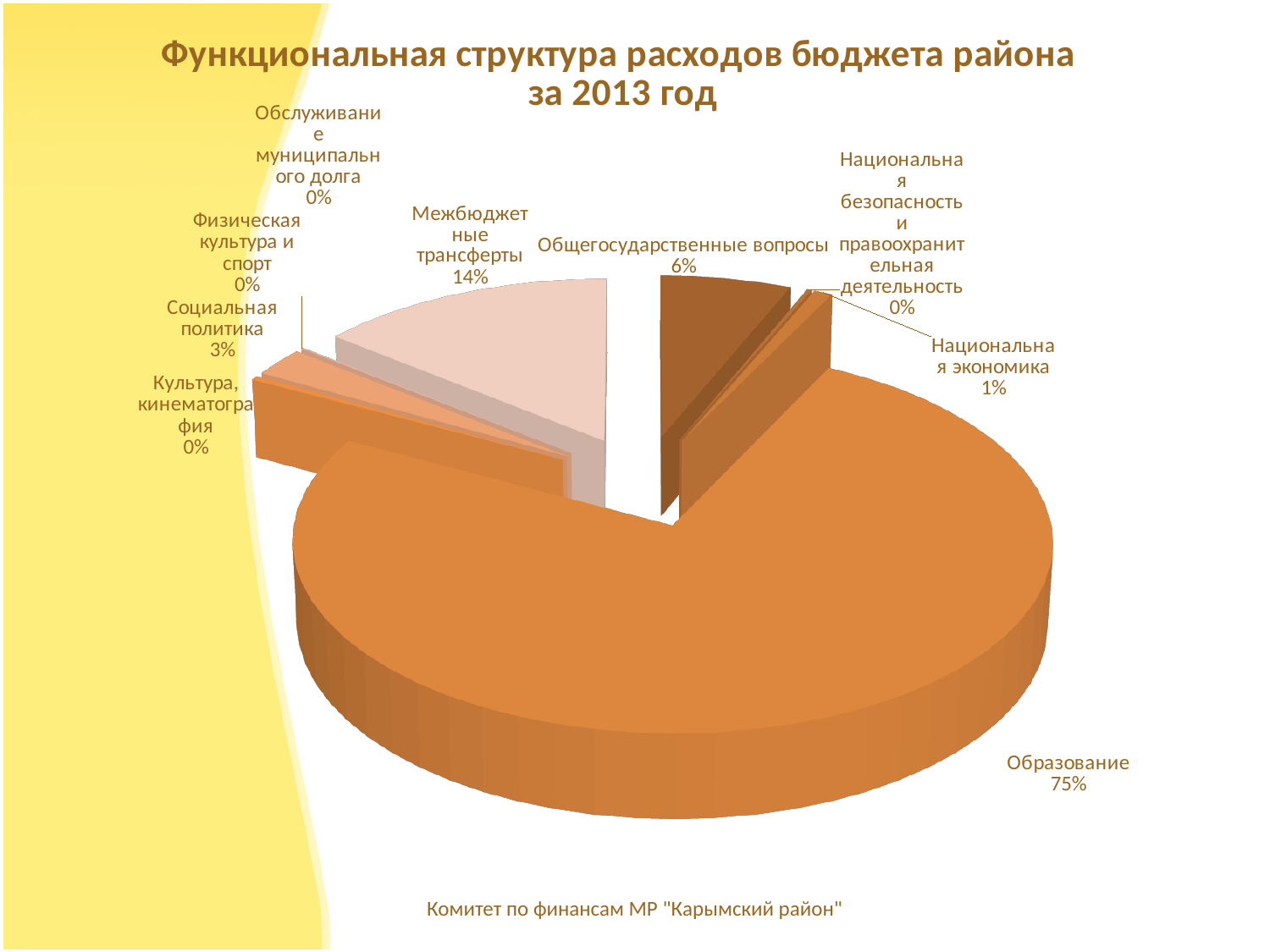
What is the value shown for Общегосударственные вопросы? 6% How many categories are labelled on the pie chart? 9 What share of the pie does Межбюджетные трансферты have? 14% What share of the pie does Образование have? 75% What is the title of the chart? Функциональная структура расходов бюджета района за 2013 год What is the value shown for Национальная экономика? 1% Which is larger, the share of Межбюджетные трансферты or the share of Общегосударственные вопросы? Межбюджетные трансферты What is the difference between the shares of Общегосударственные вопросы and Социальная политика? 3% What kind of chart is shown on the slide? Pie chart Which category has the largest share of the pie? Образование What is the value shown for Социальная политика? 3% What is the difference between the shares of Образование and Межбюджетные трансферты? 61%